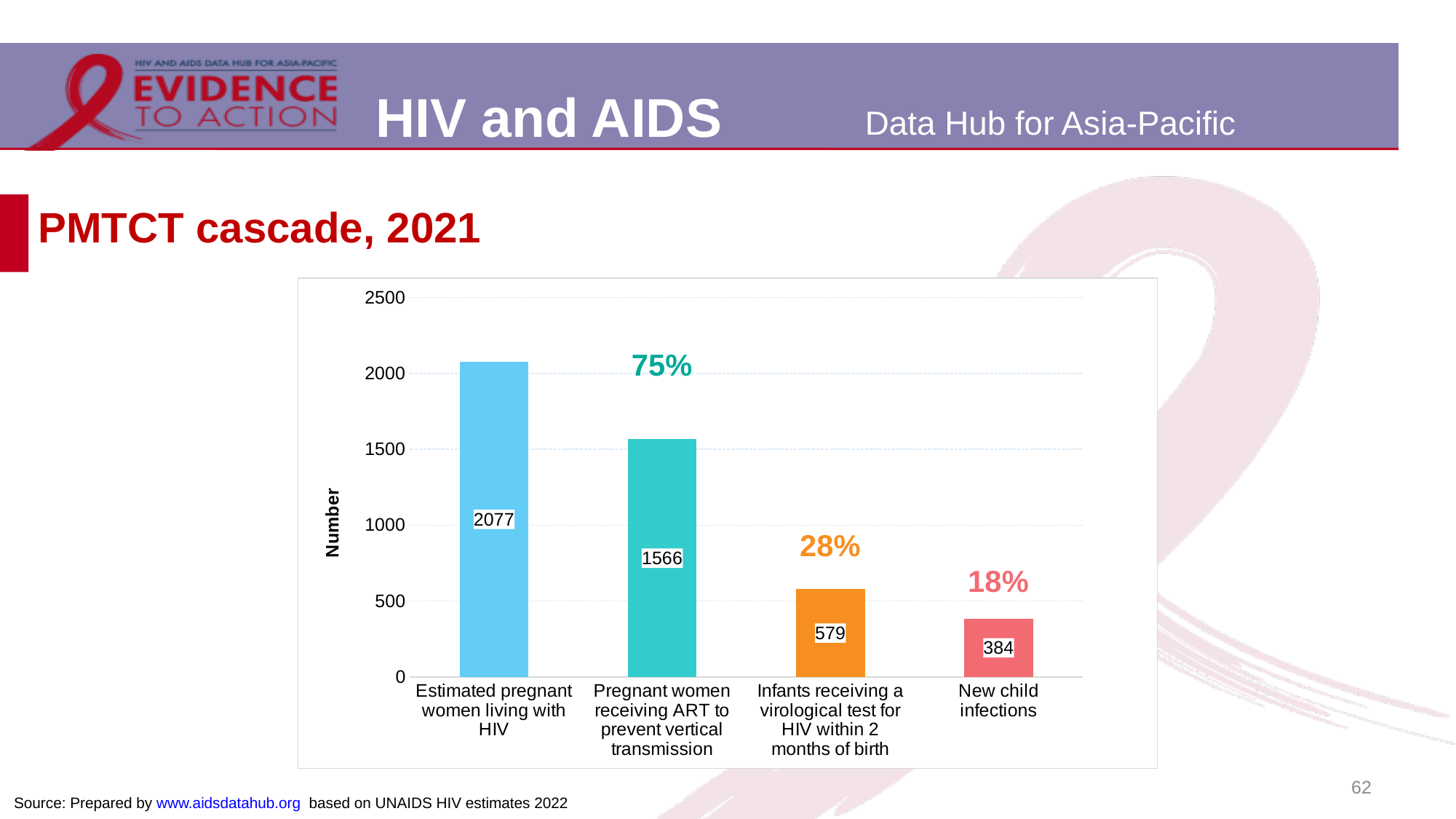
Which category has the highest value? Estimated pregnant women living with HIV What is the difference between Infants receiving a virological test for HIV within 2 months of birth and New child infections? 195 Which is larger: Pregnant women receiving ART to prevent vertical transmission or Infants receiving a virological test for HIV within 2 months of birth? Pregnant women receiving ART to prevent vertical transmission What is the difference between Estimated pregnant women living with HIV and Pregnant women receiving ART to prevent vertical transmission? 511 What is the value for Pregnant women receiving ART to prevent vertical transmission? 1566 What percentage label is shown above the Infants receiving a virological test for HIV within 2 months of birth bar? 28% What is the value for New child infections? 384 How many categories are shown on the x axis? 4 What kind of chart is shown on the slide? Bar chart What is the value for Infants receiving a virological test for HIV within 2 months of birth? 579 Which category has the lowest value? New child infections What is the value for Estimated pregnant women living with HIV? 2077